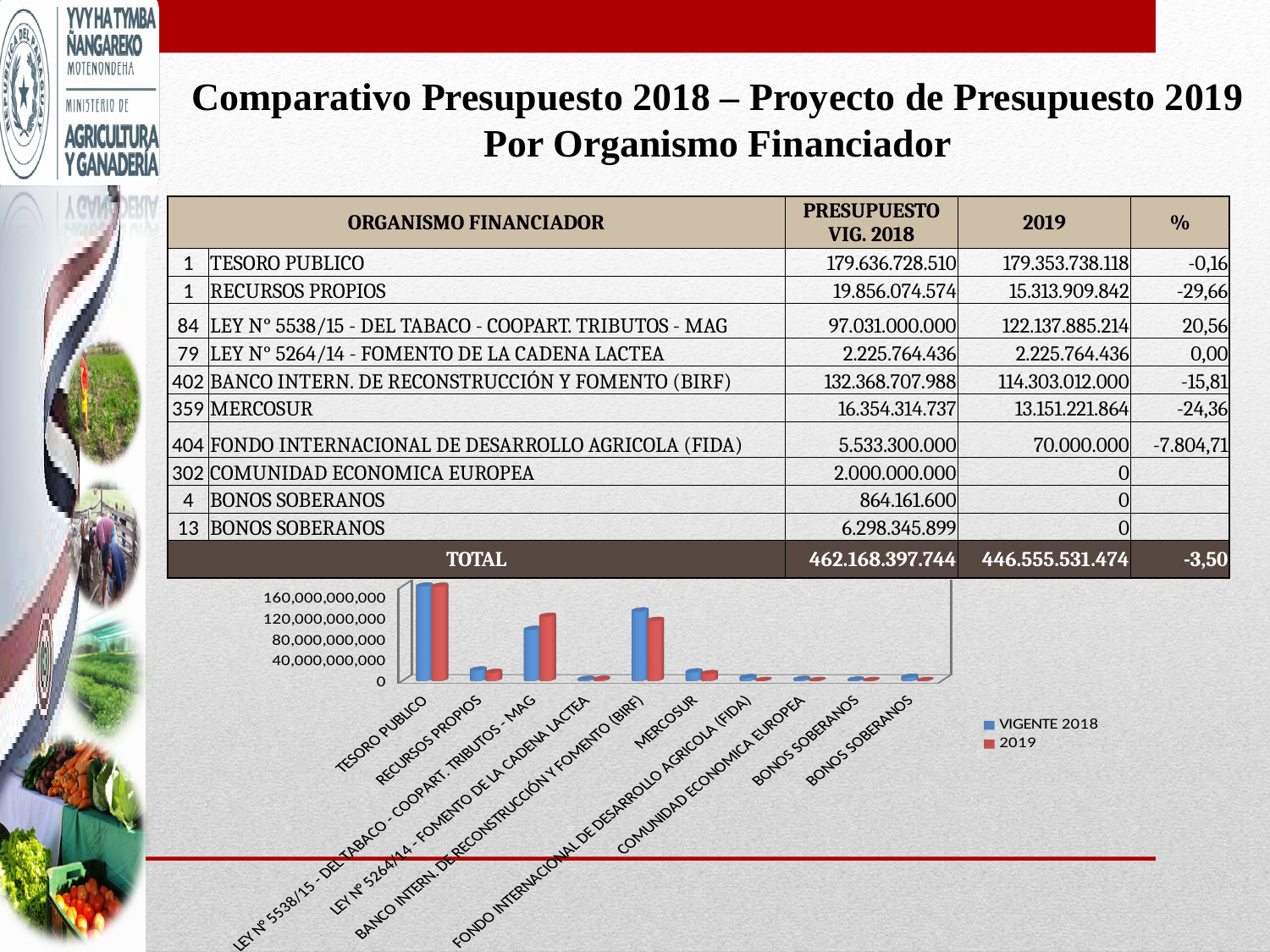
For BANCO INTERN. DE RECONSTRUCCIÓN Y FOMENTO (BIRF), which is larger: the VIGENTE 2018 bar or the 2019 bar? VIGENTE 2018 Is the VIGENTE 2018 value for TESORO PUBLICO greater or less than 160,000,000,000? greater Is the VIGENTE 2018 value for RECURSOS PROPIOS greater or less than 40,000,000,000? less How many series does the chart legend list? 2 For LEY N° 5538/15 - DEL TABACO - COOPART. TRIBUTOS - MAG, which is larger: the VIGENTE 2018 bar or the 2019 bar? 2019 Which category has the highest 2019 value in the chart? TESORO PUBLICO What kind of chart is shown at the bottom of the slide? bar chart Which category has the highest VIGENTE 2018 value in the chart? TESORO PUBLICO What are the two entries listed in the chart legend? VIGENTE 2018 and 2019 Is the VIGENTE 2018 value for BANCO INTERN. DE RECONSTRUCCIÓN Y FOMENTO (BIRF) greater or less than 120,000,000,000? greater How many categories are plotted along the x axis of the chart? 10 Which colour represents the 2019 series in the chart? red